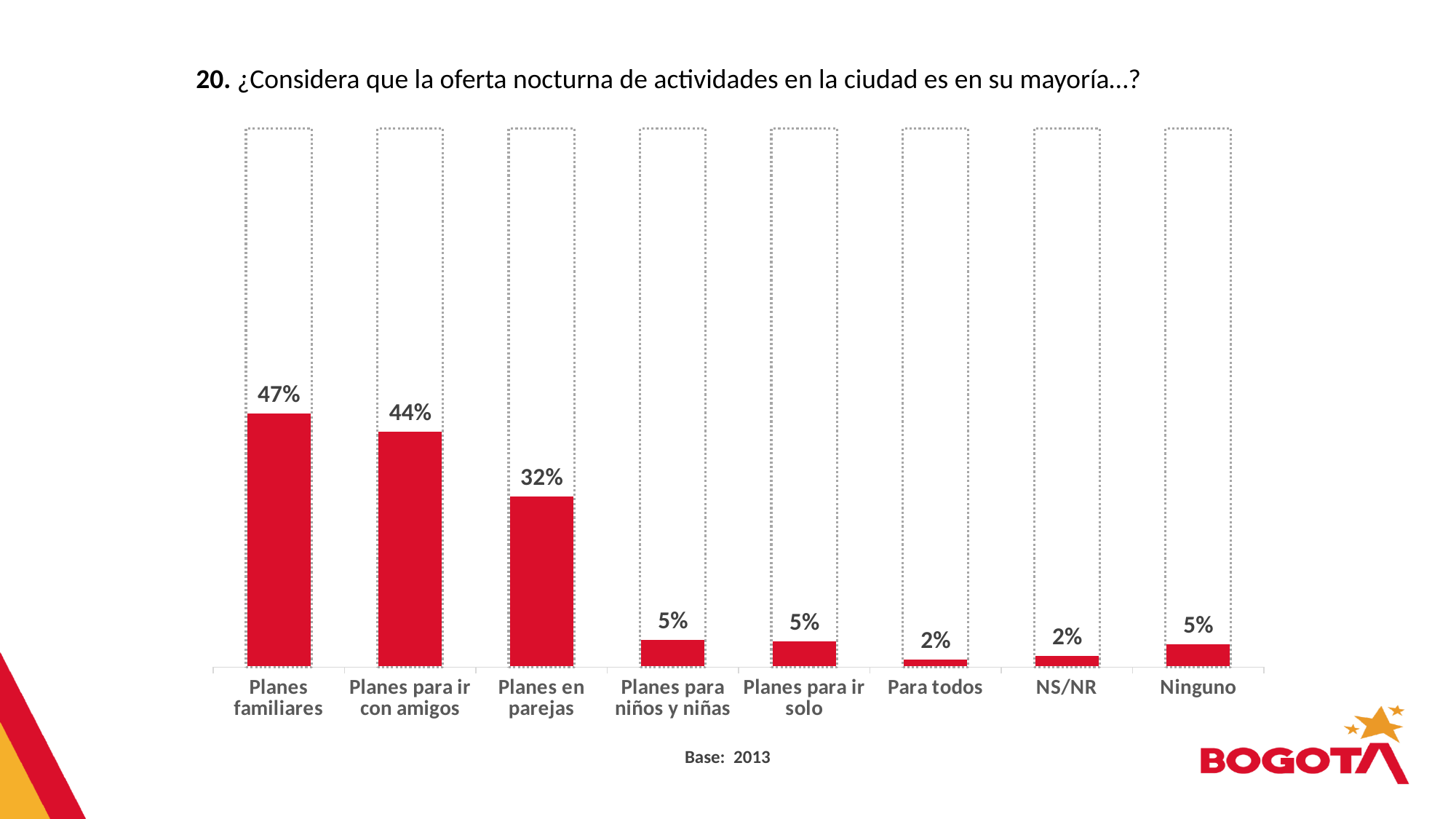
How many categories are shown in the chart? 8 What kind of chart is shown on the slide? Bar chart Which is larger, Planes en parejas or Planes para ir solo? Planes en parejas What is the base (sample size) shown below the chart? 2013 What is the value for Planes para ir con amigos? 44% What is the value for Planes familiares? 47% What is the value for Planes en parejas? 32% What is the difference between Planes para ir con amigos and Planes en parejas? 12% What is the difference between Planes familiares and Planes para ir con amigos? 3% Which category has the highest value? Planes familiares What is the value for Para todos? 2% What is the value for Ninguno? 5%